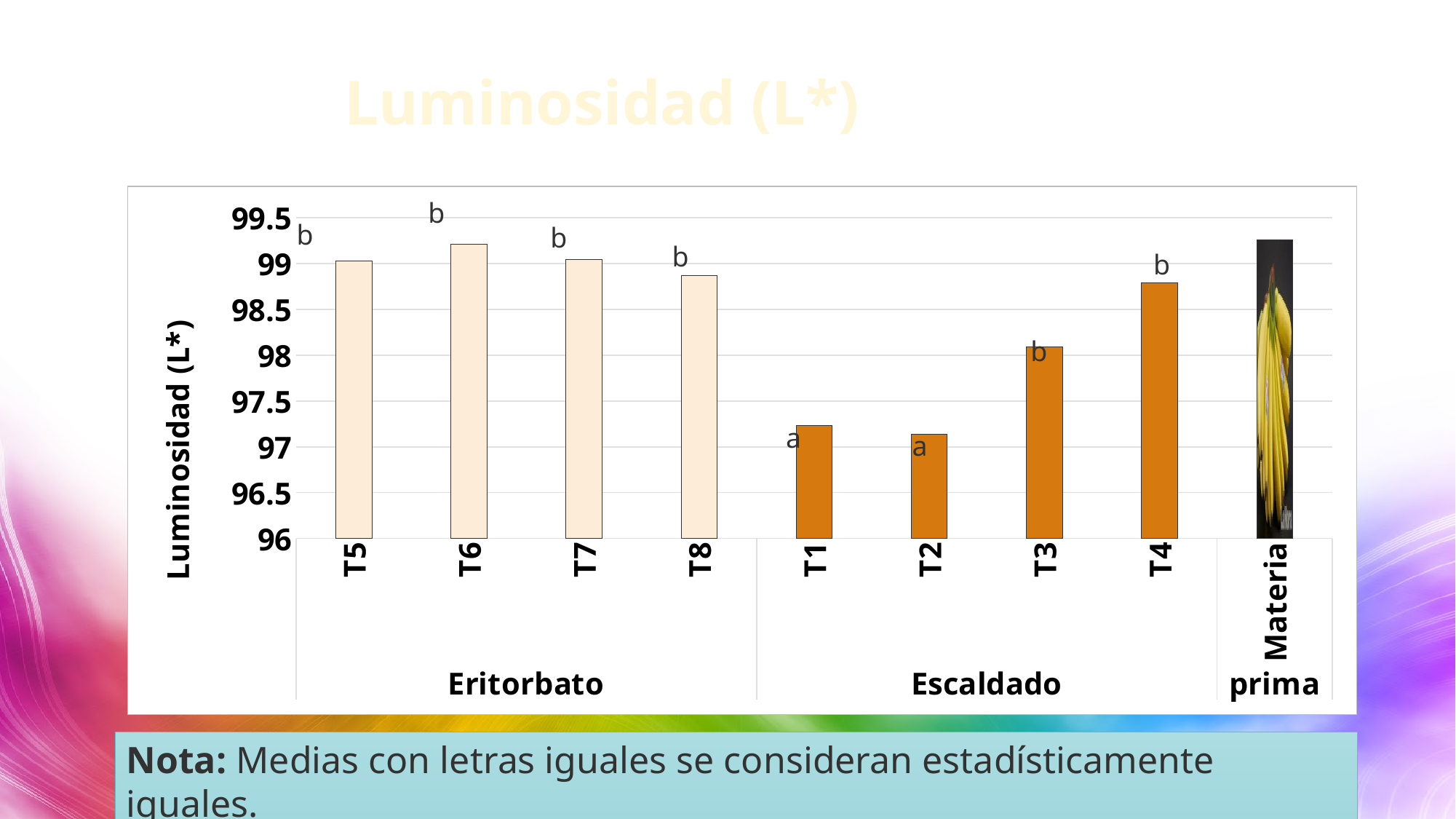
Which has the larger value, T6 or T8? T6 Is the value for T3 greater or less than 98? greater How many bars are plotted in the chart? 9 Is the value for T6 greater or less than 99? greater Which has the larger value, T4 or T3? T4 What is the title of the y axis? Luminosidad (L*) Which statistical letter is shown above the T1 bar? a What kind of chart is shown on the slide? bar chart Is the value for T1 greater or less than 97.5? less Which has the larger value, T3 or T1? T3